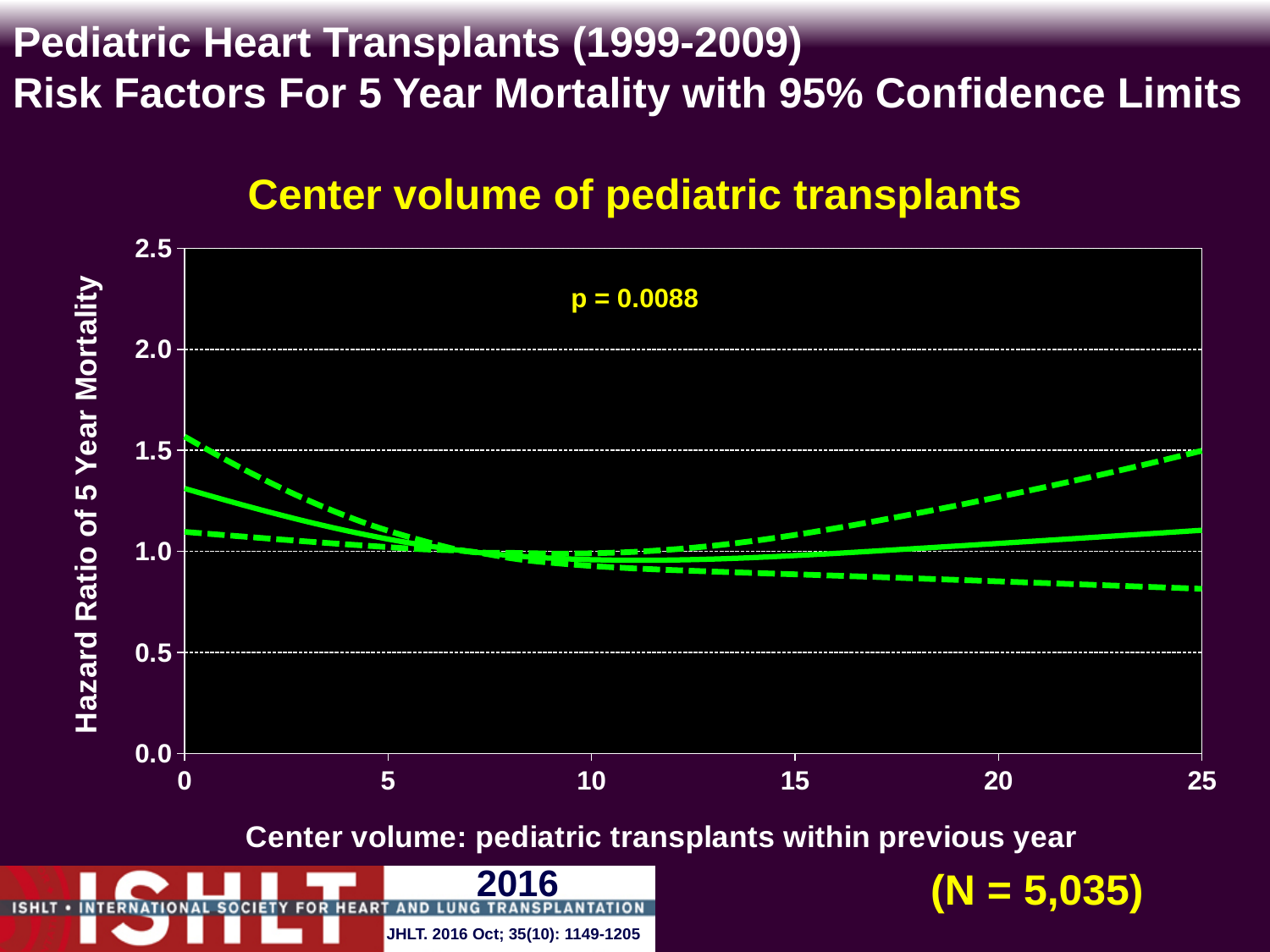
What is the label of the y-axis? Hazard Ratio of 5 Year Mortality Does the solid line rise or fall between a center volume of 0 and 5? fall What p-value is printed on the chart? p = 0.0088 What is the highest value shown on the y-axis? 2.5 Is the value of the lower dashed line at a center volume of 25 greater or less than 1.0? less Does the upper dashed line rise or fall between a center volume of 15 and 25? rise What sample size (N) is shown on the slide? N = 5,035 What is the title of the chart? Center volume of pediatric transplants What kind of chart is shown on the slide? line chart How many lines are plotted on the chart? 3 Is the value of the solid line at a center volume of 0 greater or less than 1.0? greater Is the value of the upper dashed line at a center volume of 0 greater or less than 1.0? greater